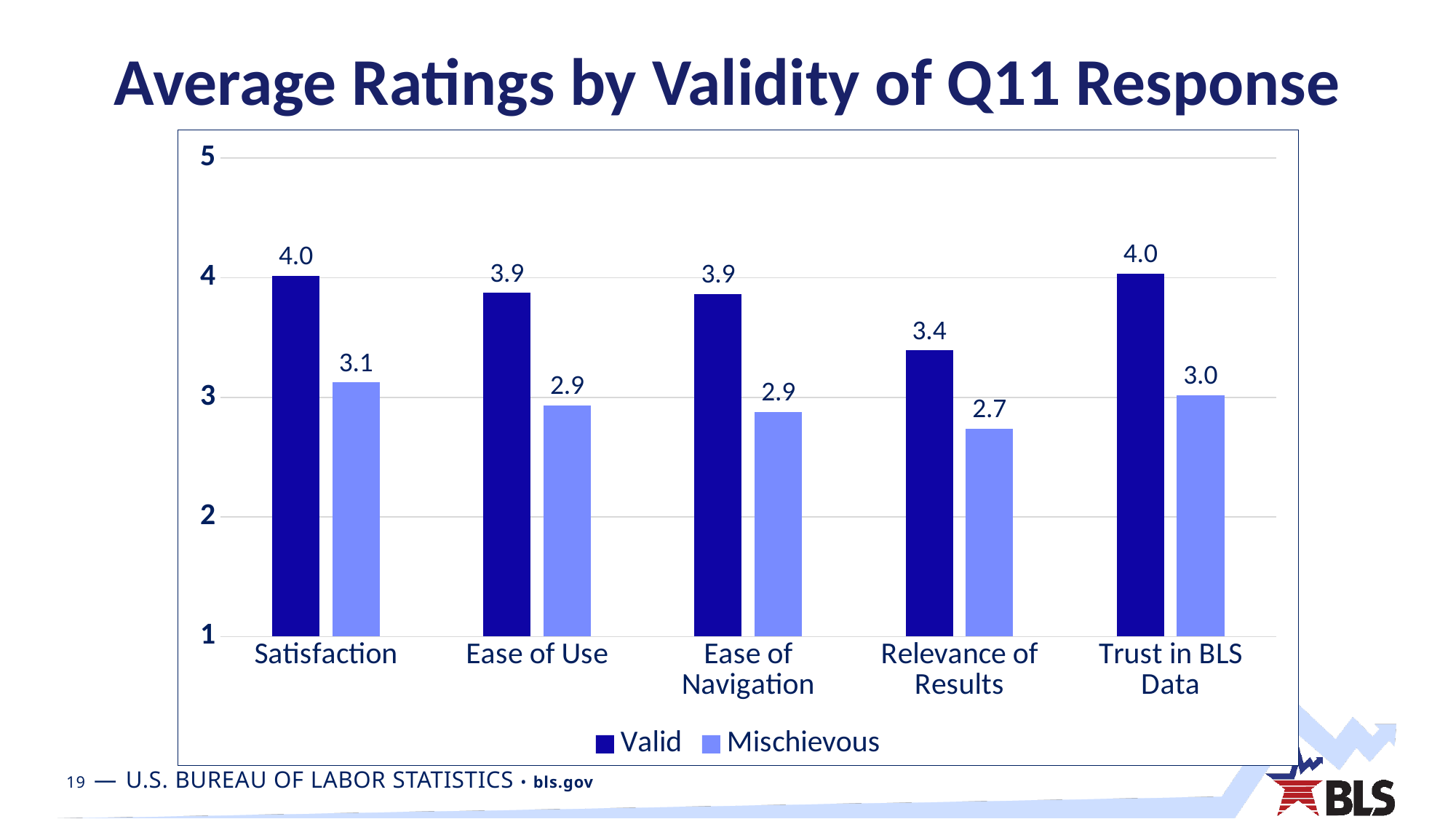
What is the Mischievous rating for Relevance of Results? 2.7 Is the Mischievous rating for Relevance of Results greater or less than 3? less What kind of chart is shown on the slide? bar chart How many categories are shown on the x axis? 5 Which is larger, the Valid rating for Relevance of Results or the Mischievous rating for Satisfaction? Valid rating for Relevance of Results How many series does the legend list? 2 Which category has the highest Mischievous rating? Satisfaction What is the Mischievous rating for Trust in BLS Data? 3.0 What is the Valid rating for Satisfaction? 4.0 What is the difference between the Valid and Mischievous ratings for Satisfaction? 0.9 What is the difference between the Valid and Mischievous ratings for Ease of Navigation? 1.0 Which category has the lowest Valid rating? Relevance of Results